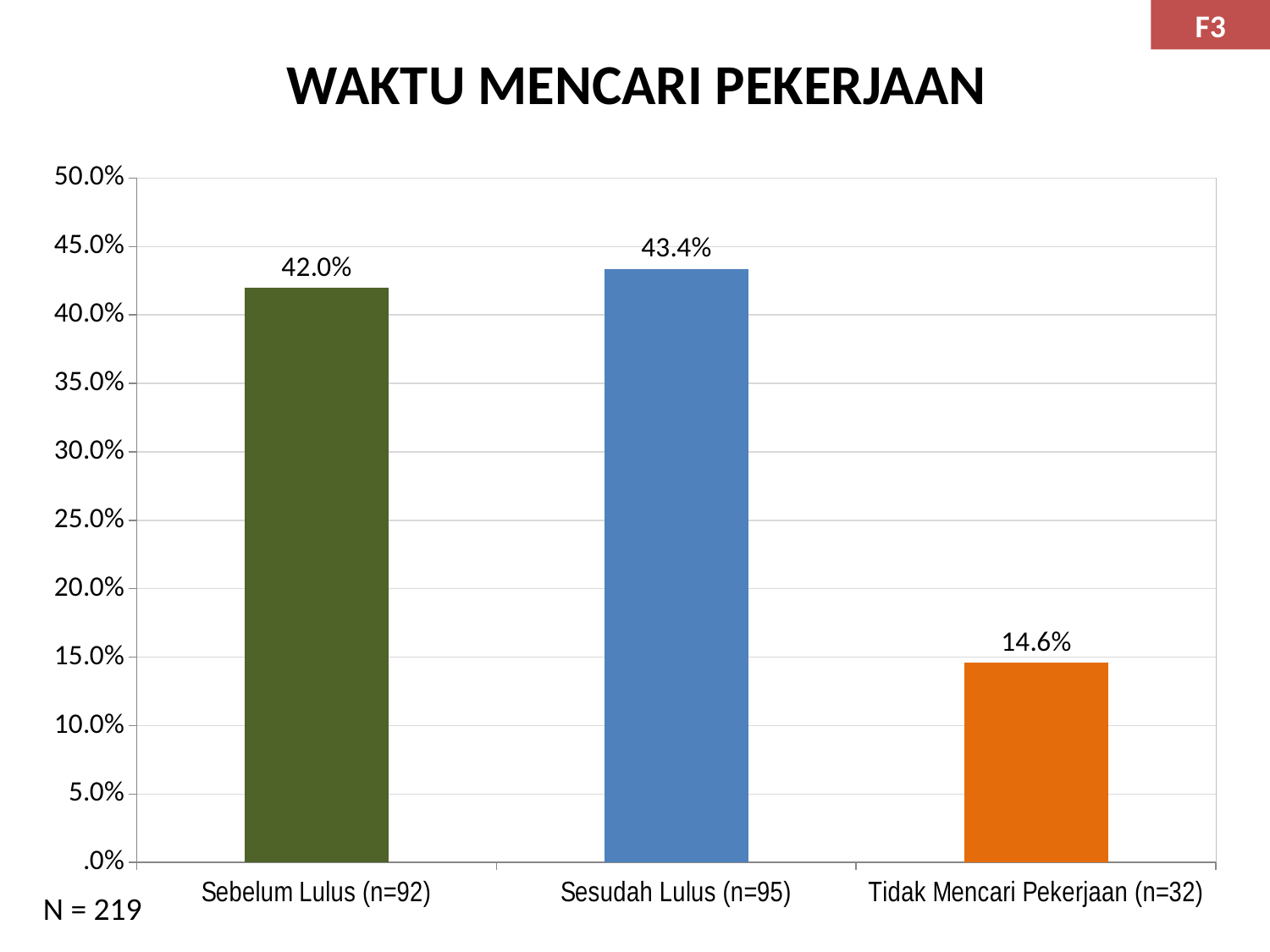
Is the value for Tidak Mencari Pekerjaan (n=32) greater or less than 20.0%? less What is the value for Sesudah Lulus (n=95)? 43.4% What is the value for Sebelum Lulus (n=92)? 42.0% What is the difference between the values for Sesudah Lulus (n=95) and Sebelum Lulus (n=92)? 1.4% What kind of chart is shown on the slide? bar chart What is the difference between the values for Sebelum Lulus (n=92) and Tidak Mencari Pekerjaan (n=32)? 27.4% Which category has the lowest value? Tidak Mencari Pekerjaan (n=32) What is the value for Tidak Mencari Pekerjaan (n=32)? 14.6% Which is larger, the value for Sebelum Lulus (n=92) or Tidak Mencari Pekerjaan (n=32)? Sebelum Lulus (n=92) What is the title of the chart? WAKTU MENCARI PEKERJAAN How many categories are shown in the chart? 3 Which category has the highest value? Sesudah Lulus (n=95)